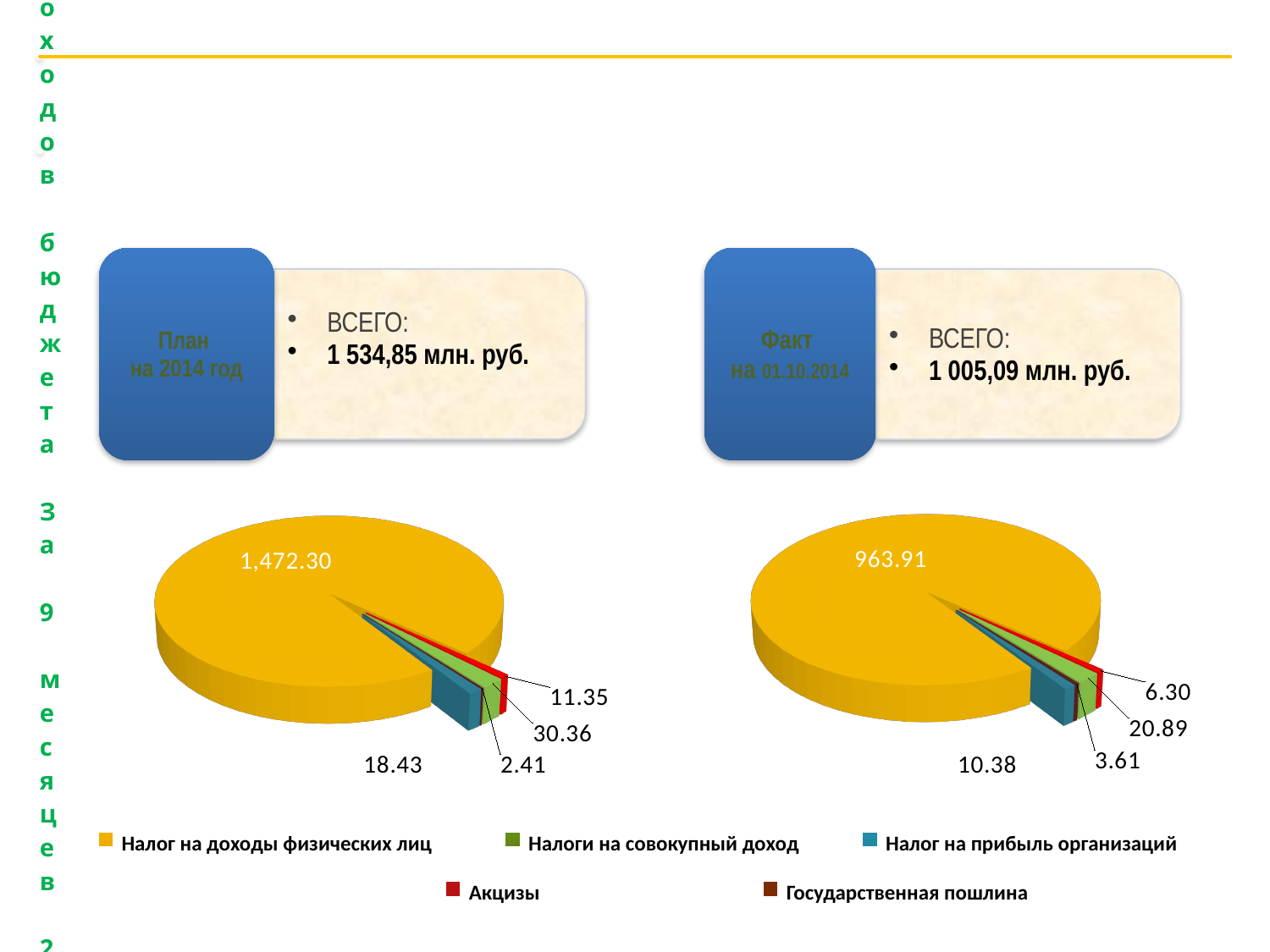
In the left pie chart (План на 2014 год), what is the value for Налоги на совокупный доход? 30.36 In the left pie chart (План на 2014 год), what is the value for Налог на доходы физических лиц? 1,472.30 What colour represents Акцизы in the pie charts? Red How many categories does the legend list for the pie charts? 5 In the right pie chart (Факт на 01.10.2014), what is the value for Акцизы? 6.30 What type of chart is used on the left side of the slide (План на 2014 год)? Pie chart In the left pie chart (План на 2014 год), which category has the smallest slice? Государственная пошлина In the right pie chart (Факт на 01.10.2014), which category has the largest slice? Налог на доходы физических лиц In the left pie chart (План на 2014 год), which is larger: Налог на прибыль организаций or Акцизы? Налог на прибыль организаций In the right pie chart (Факт на 01.10.2014), what is the value for Налог на доходы физических лиц? 963.91 In the right pie chart (Факт на 01.10.2014), what is the value for Налог на прибыль организаций? 10.38 What is the difference between the Налог на доходы физических лиц value in the left pie chart (1,472.30) and in the right pie chart (963.91)? 508.39